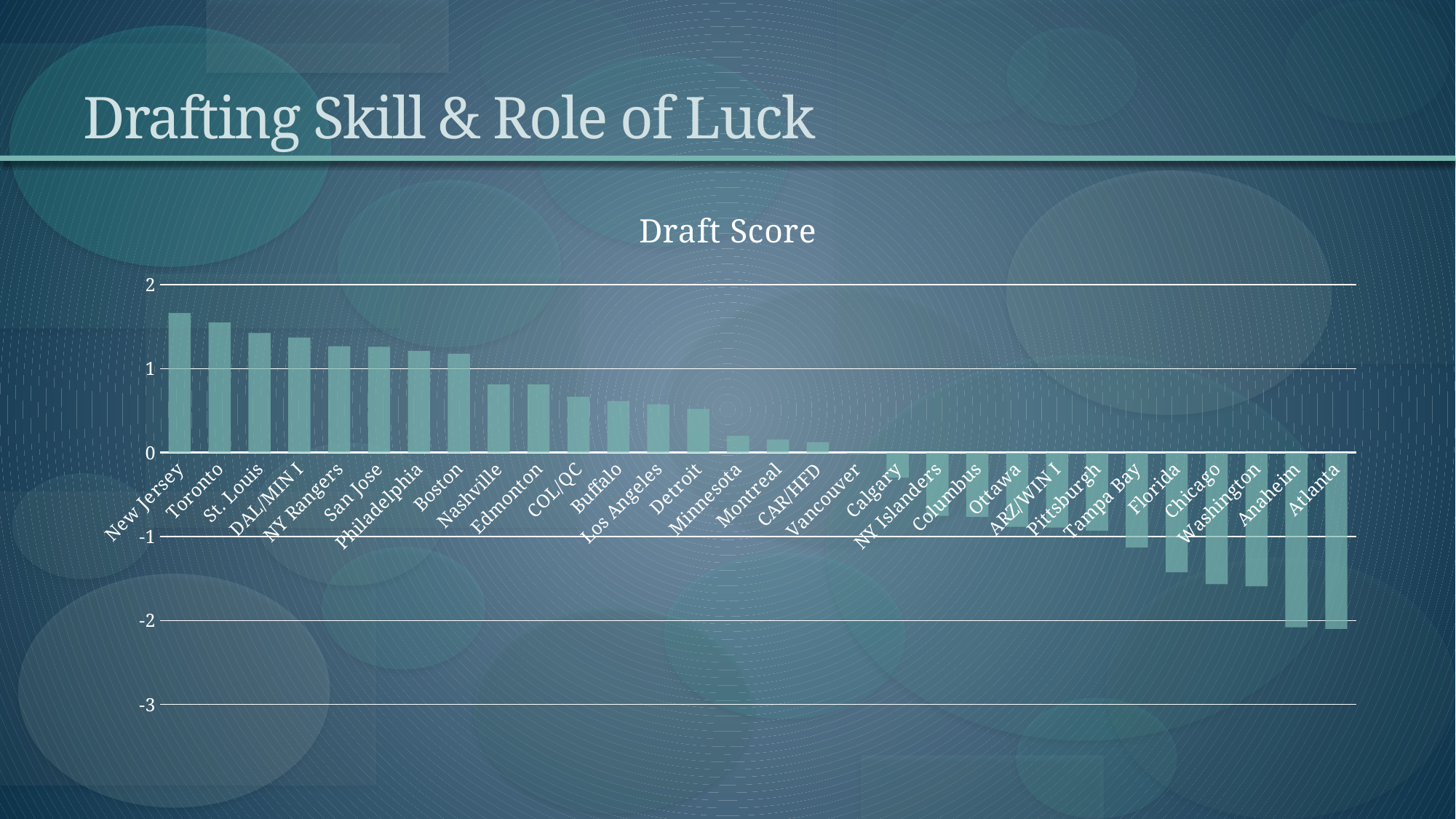
Do the Draft Score values rise or fall moving from left to right along the x axis? Fall Is the Draft Score for Calgary greater or less than -1? greater Which team has the highest Draft Score? New Jersey Is the Draft Score for Nashville greater or less than 1? less What is the title of the chart? Draft Score Is the Draft Score for Chicago greater or less than -1? less Which has a higher Draft Score, Toronto or Boston? Toronto How many teams (categories) are plotted in the Draft Score chart? 30 What kind of chart is shown on the slide? Bar chart Which has a higher Draft Score, Calgary or Washington? Calgary